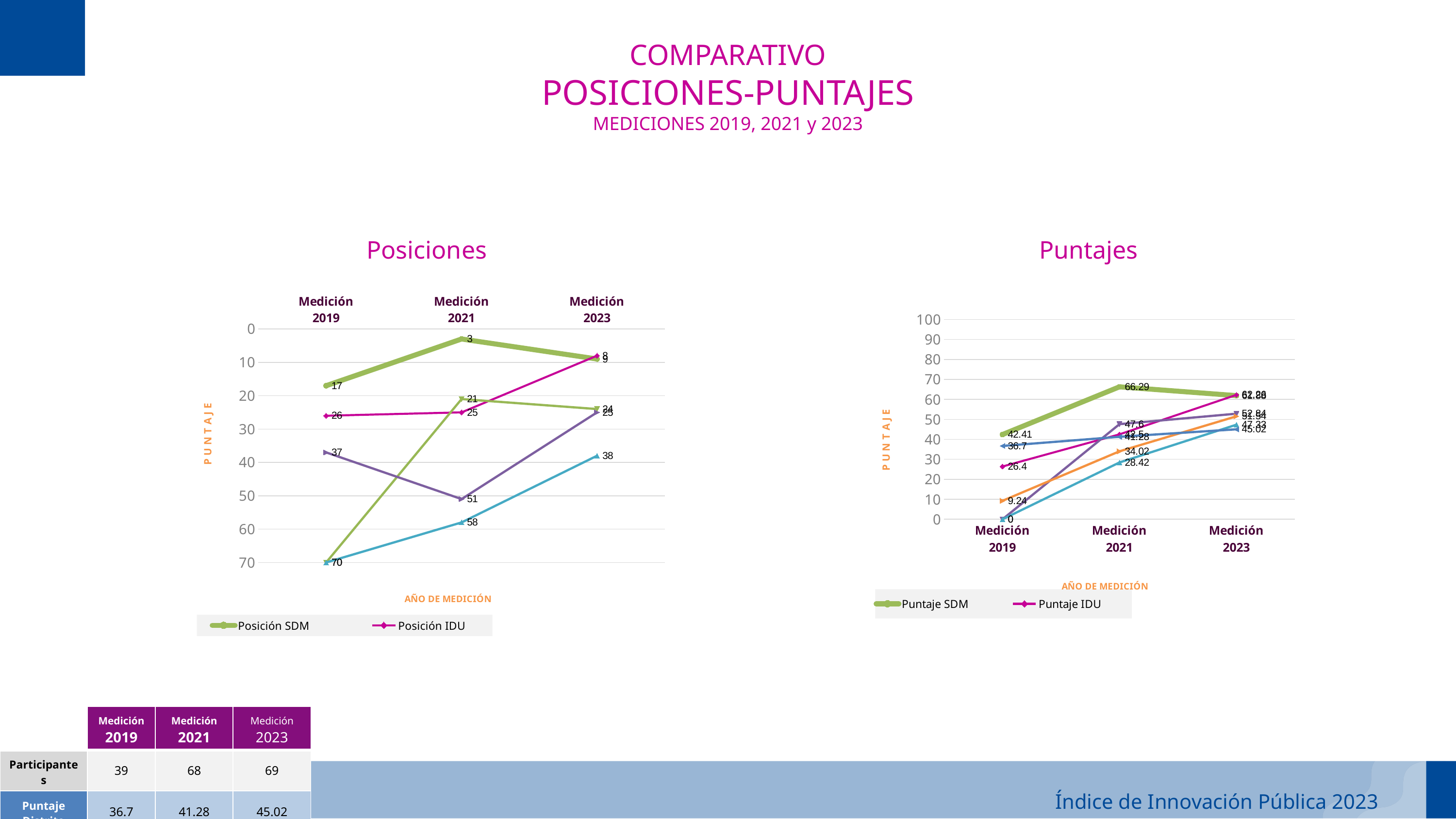
In the Posiciones chart, which series has the larger value at Medición 2021, Posición SDM or Posición IDU? Posición IDU In the Puntajes chart, what is the value of Puntaje IDU for Medición 2019? 26.4 In the Posiciones chart, what is the value of Posición SDM for Medición 2021? 3 In the Posiciones chart, what is the value of Posición SDM for Medición 2019? 17 In the Posiciones chart, what is the difference between the Posición IDU values for Medición 2019 and Medición 2023? 18 In the Puntajes chart, in which measurement does Puntaje SDM reach its highest value? Medición 2021 How many series does the legend of the Posiciones chart list? 2 What kind of chart is the Puntajes chart? Line chart In the Puntajes chart, what is the value of Puntaje SDM for Medición 2021? 66.29 In the Puntajes chart, does Puntaje IDU rise or fall from Medición 2019 to Medición 2023? Rise In the Puntajes chart, is the value of Puntaje IDU for Medición 2023 greater or less than 50? greater In the Posiciones chart, what is the value of Posición IDU for Medición 2023? 8